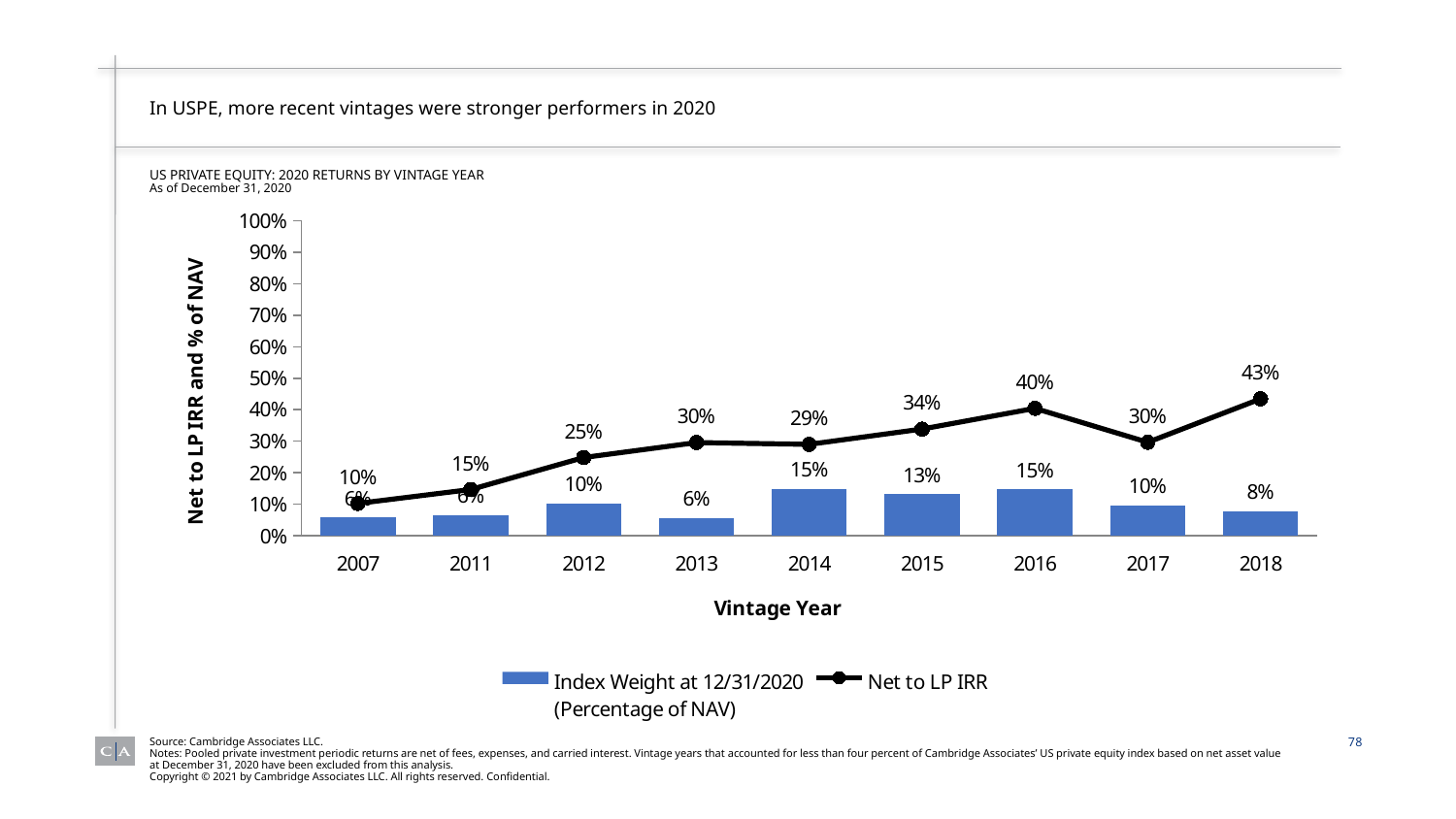
Is the Net to LP IRR for 2013 greater or less than 20%? greater Which is larger, the Net to LP IRR for 2015 or for 2014? 2015 What is the Net to LP IRR for the 2018 vintage year? 43% What is the difference between the Net to LP IRR for 2016 and for 2017? 10% What is the Net to LP IRR for the 2012 vintage year? 25% What is the Index Weight at 12/31/2020 for the 2017 vintage year? 10% Which vintage year has the highest Net to LP IRR? 2018 How many vintage years are shown on the x axis? 9 How many series does the legend list? 2 What is the label of the y axis? Net to LP IRR and % of NAV What is the Index Weight at 12/31/2020 for the 2014 vintage year? 15% Which vintage year has the lowest Net to LP IRR? 2007